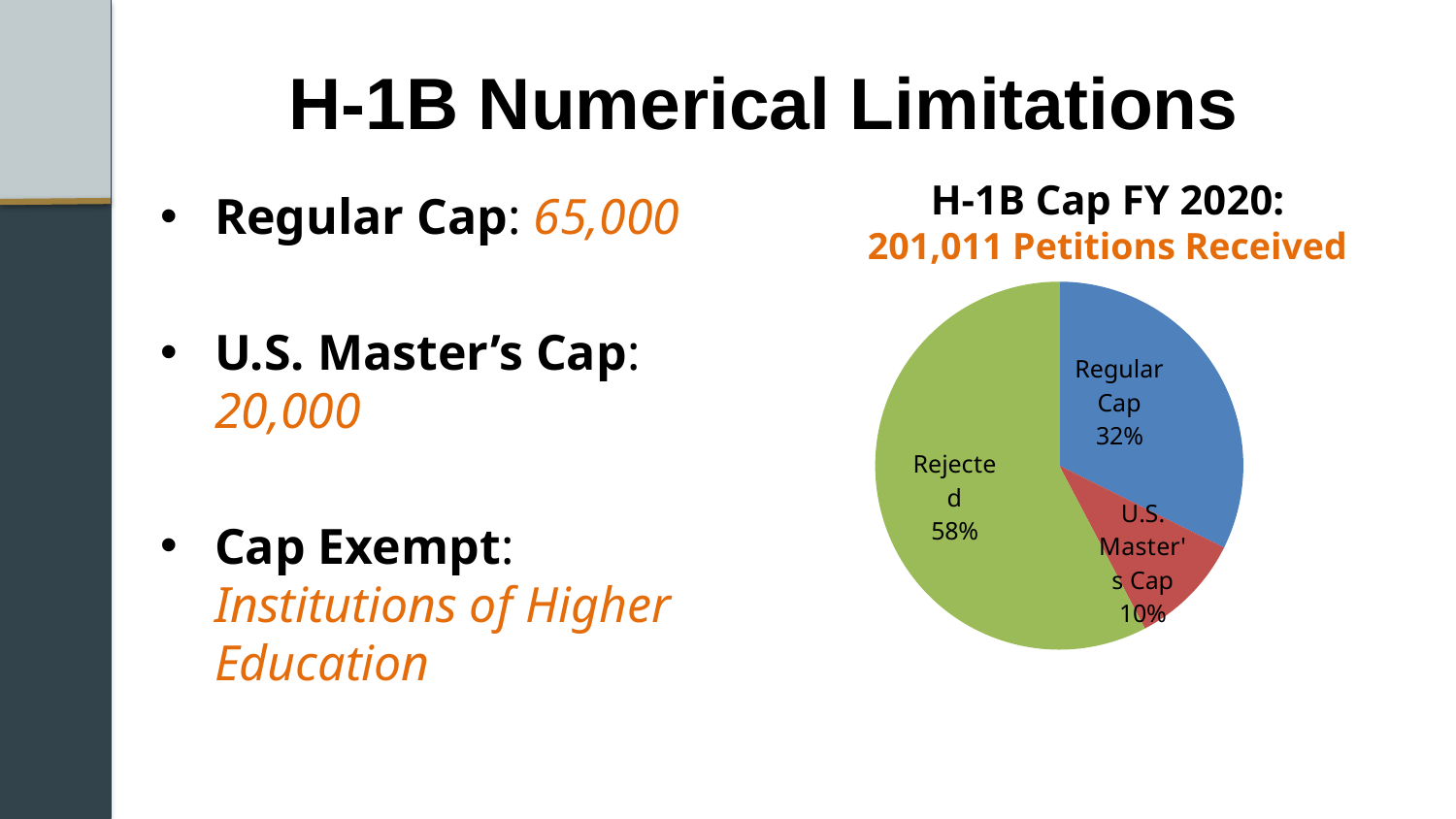
What share of the pie does the U.S. Master's Cap slice represent? 10% Which slice of the pie is the smallest? U.S. Master's Cap Which slice of the pie is the largest? Rejected What kind of chart is shown on the slide? pie chart Which slice is larger, Regular Cap or U.S. Master's Cap? Regular Cap What share of the pie does the Rejected slice represent? 58% How many slices does the pie chart have? 3 What is the title of the pie chart? H-1B Cap FY 2020: 201,011 Petitions Received What is the difference in percentage points between the Regular Cap slice and the U.S. Master's Cap slice? 22 What share of the pie does the Regular Cap slice represent? 32% What colour is the Rejected slice of the pie? green What is the difference in percentage points between the Rejected slice and the Regular Cap slice? 26